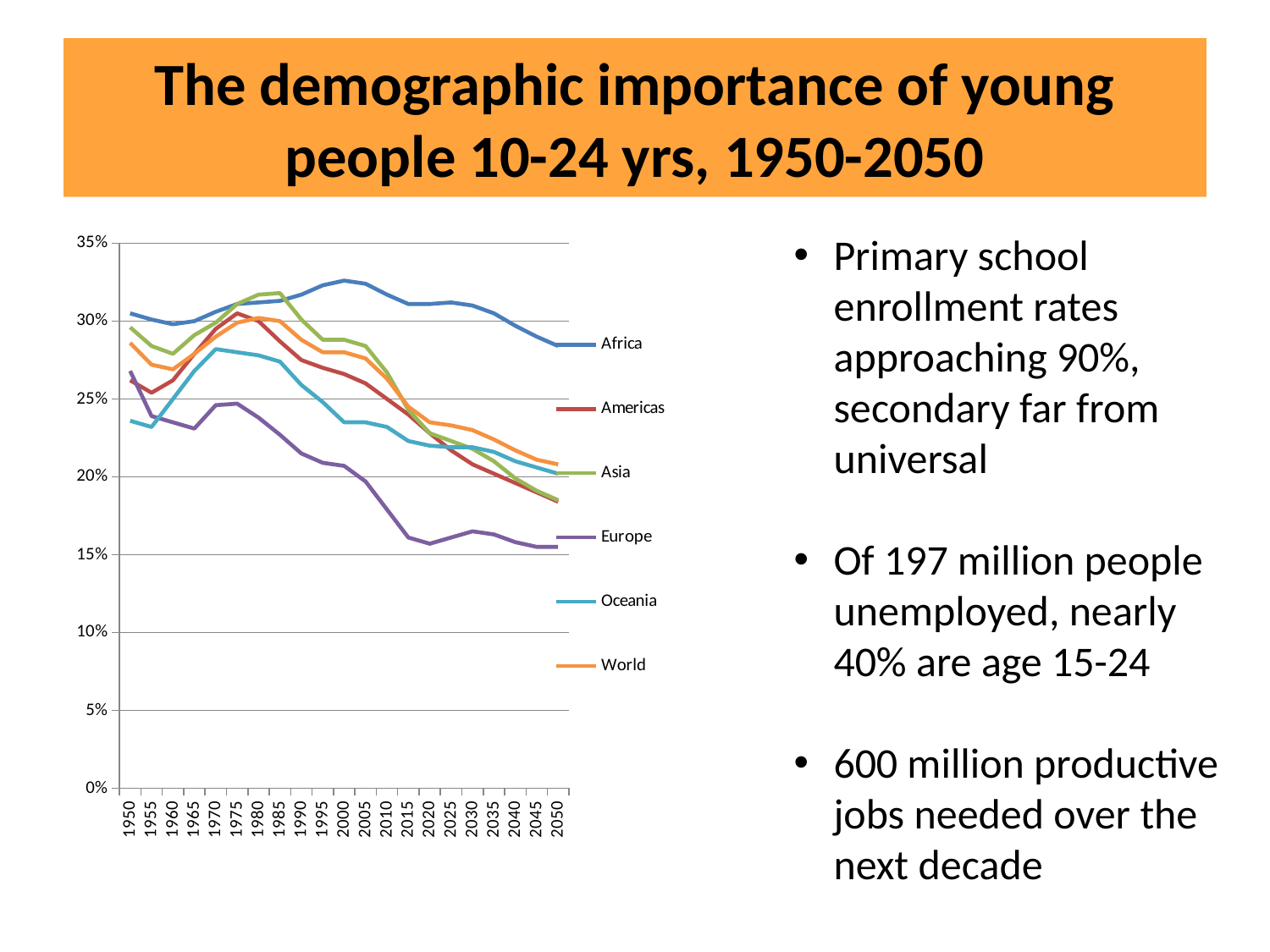
How many series does the chart's legend list? 6 Is the value for Africa in 2000 greater or less than 30%? greater Is the value for Europe in 2050 greater or less than 20%? less Which series has the lowest value in 1950? Oceania Is the value for Americas in 2050 greater or less than 20%? less Which series has the lowest value in 2050? Europe Does the Europe line rise or fall overall from 1950 to 2050? fall Which series has the highest value in 2050? Africa How many years are marked along the x axis of the chart? 21 What kind of chart is shown on the slide? line chart In 2050, which is larger: the value for Africa or the value for Europe? Africa